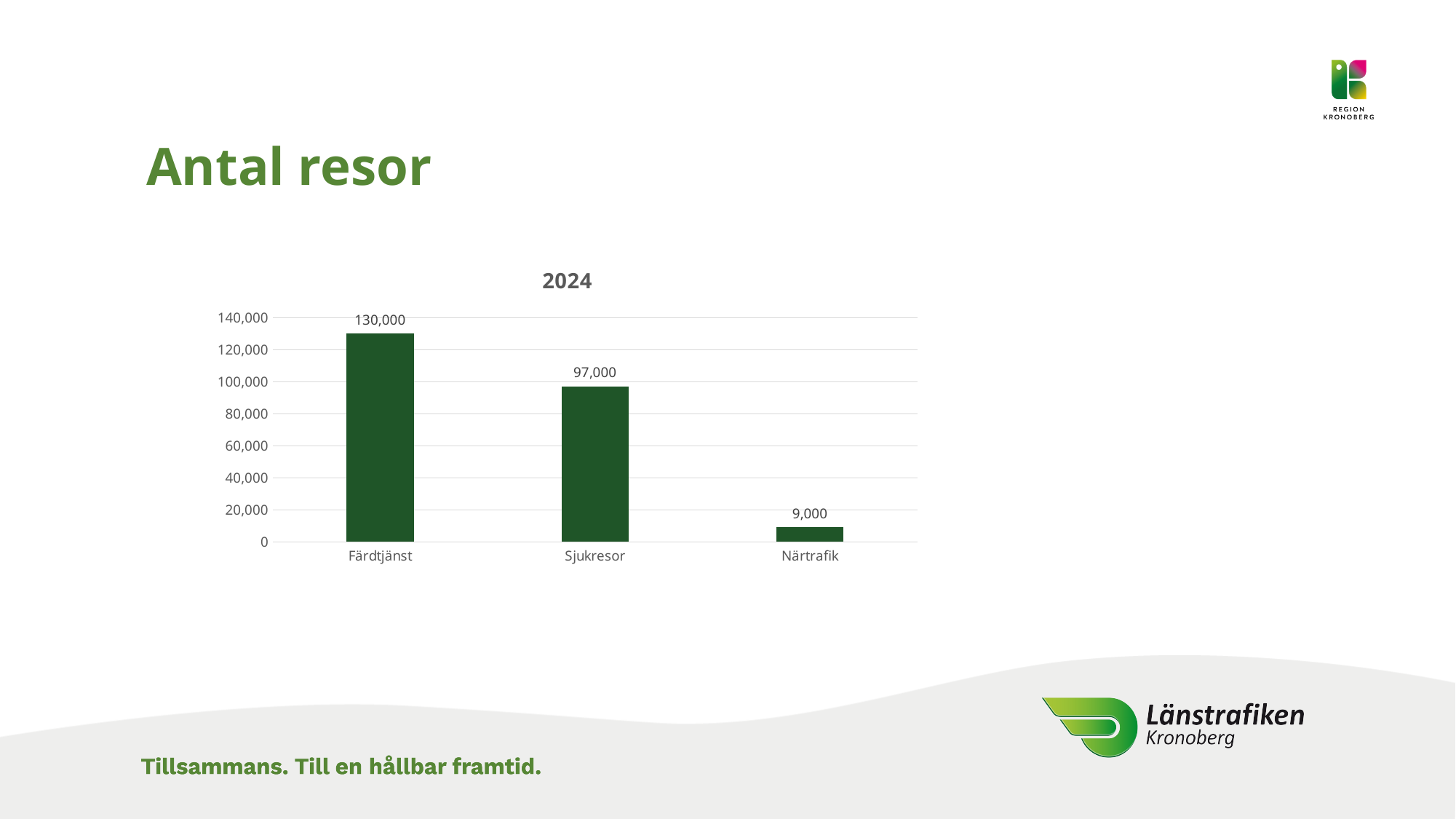
Which category has the highest value? Färdtjänst What is the difference between the values for Sjukresor and Närtrafik? 88,000 What kind of chart is shown on the slide? bar chart Which is larger, the value for Sjukresor or the value for Närtrafik? Sjukresor Is the value for Sjukresor greater or less than 100,000? less What is the value for Färdtjänst? 130,000 What is the value for Närtrafik? 9,000 Which category has the lowest value? Närtrafik What is the value for Sjukresor? 97,000 What is the difference between the values for Färdtjänst and Sjukresor? 33,000 What is the title of the chart? 2024 How many categories are shown on the x axis? 3